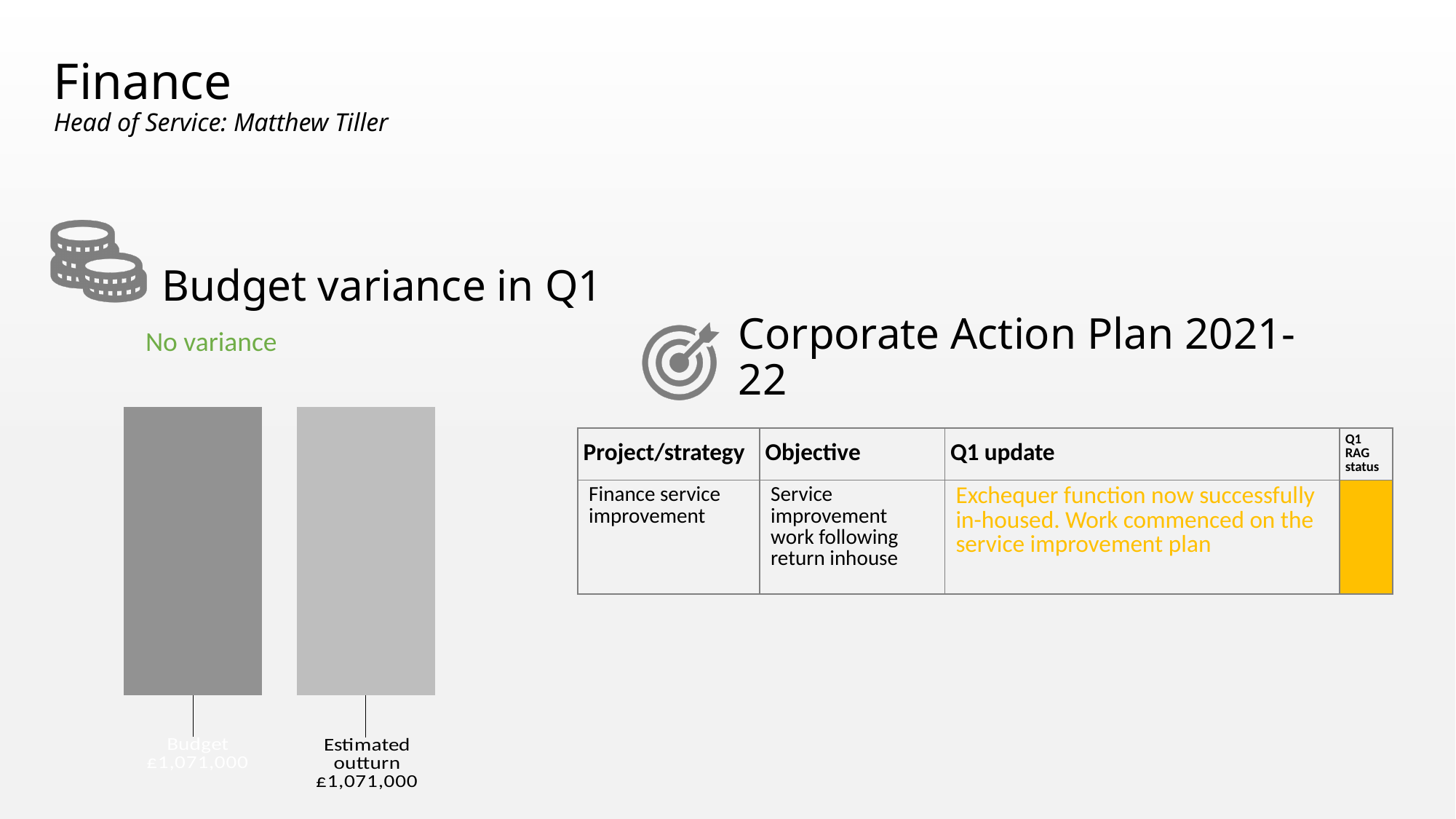
In the 'Budget variance in Q1' chart, what is the difference between the Budget and the Estimated outturn? £0 In the 'Budget variance in Q1' chart, what is the value of the Estimated outturn bar? £1,071,000 What is the title of the chart on the left of the slide? Budget variance in Q1 What green annotation appears above the 'Budget variance in Q1' chart? No variance What kind of chart is shown under the heading 'Budget variance in Q1'? bar chart What are the labels of the two bars in the 'Budget variance in Q1' chart? Budget and Estimated outturn In the 'Budget variance in Q1' chart, what is the value of the Budget bar? £1,071,000 How many bars are plotted in the 'Budget variance in Q1' chart? 2